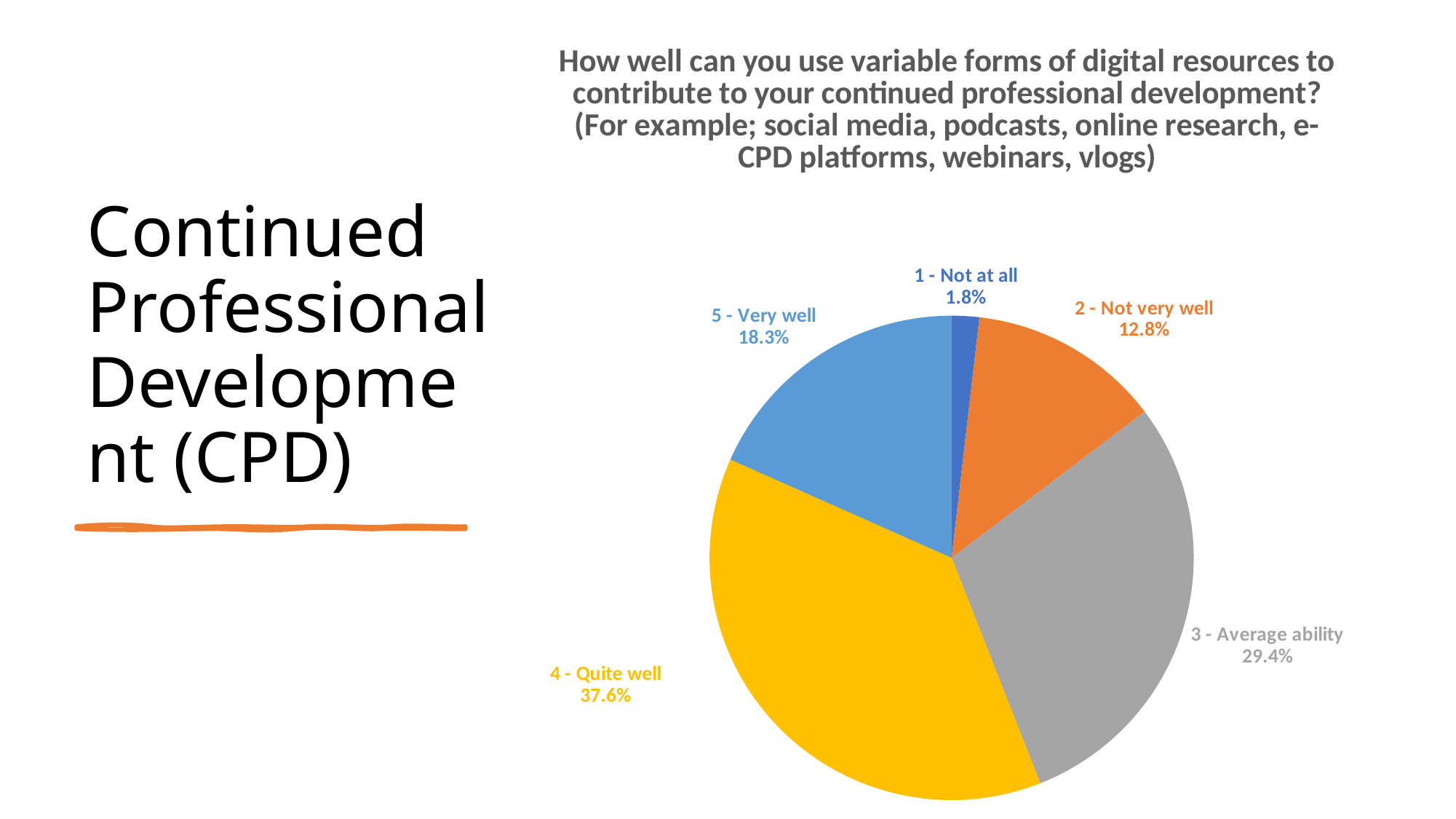
What is the difference between the shares for "4 - Quite well" and "3 - Average ability"? 8.2% Which category has the smallest slice of the pie? 1 - Not at all What share of the pie does "4 - Quite well" represent? 37.6% What is the value for "2 - Not very well"? 12.8% Which category has the largest slice of the pie? 4 - Quite well What is the value for "5 - Very well"? 18.3% What colour is the slice for "3 - Average ability"? grey What is the value for "1 - Not at all"? 1.8% What kind of chart is shown on the slide? pie chart How many categories are shown in the pie chart? 5 What share of the pie does "3 - Average ability" represent? 29.4% Which is larger, the share for "5 - Very well" or the share for "2 - Not very well"? 5 - Very well